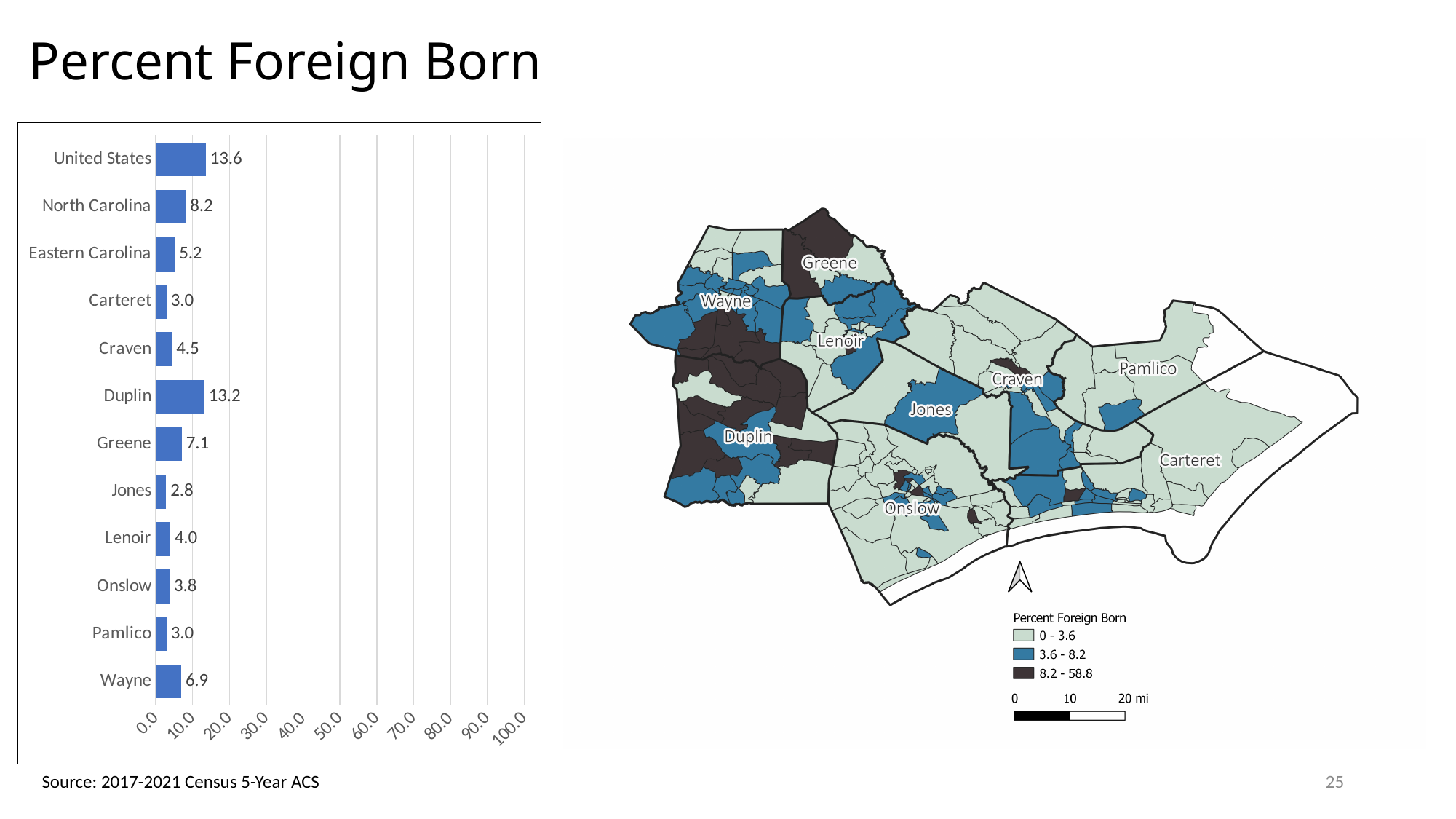
What is the highest value labelled on the x axis of the bar chart? 100.0 How many categories are shown in the bar chart? 12 What kind of chart is shown on the left of the slide? bar chart Which category has the highest value in the bar chart? United States In the bar chart, which is larger: the value for Craven or the value for Lenoir? Craven What value does the bar chart show for North Carolina? 8.2 Which category has the lowest value in the bar chart? Jones What is the value for Eastern Carolina in the bar chart? 5.2 What is the difference between the Greene and Wayne values in the bar chart? 0.2 What is the difference between the United States value and the Duplin value in the bar chart? 0.4 What is the percent foreign born value shown for Duplin in the bar chart? 13.2 Is the value for Onslow in the bar chart greater or less than 10.0? less